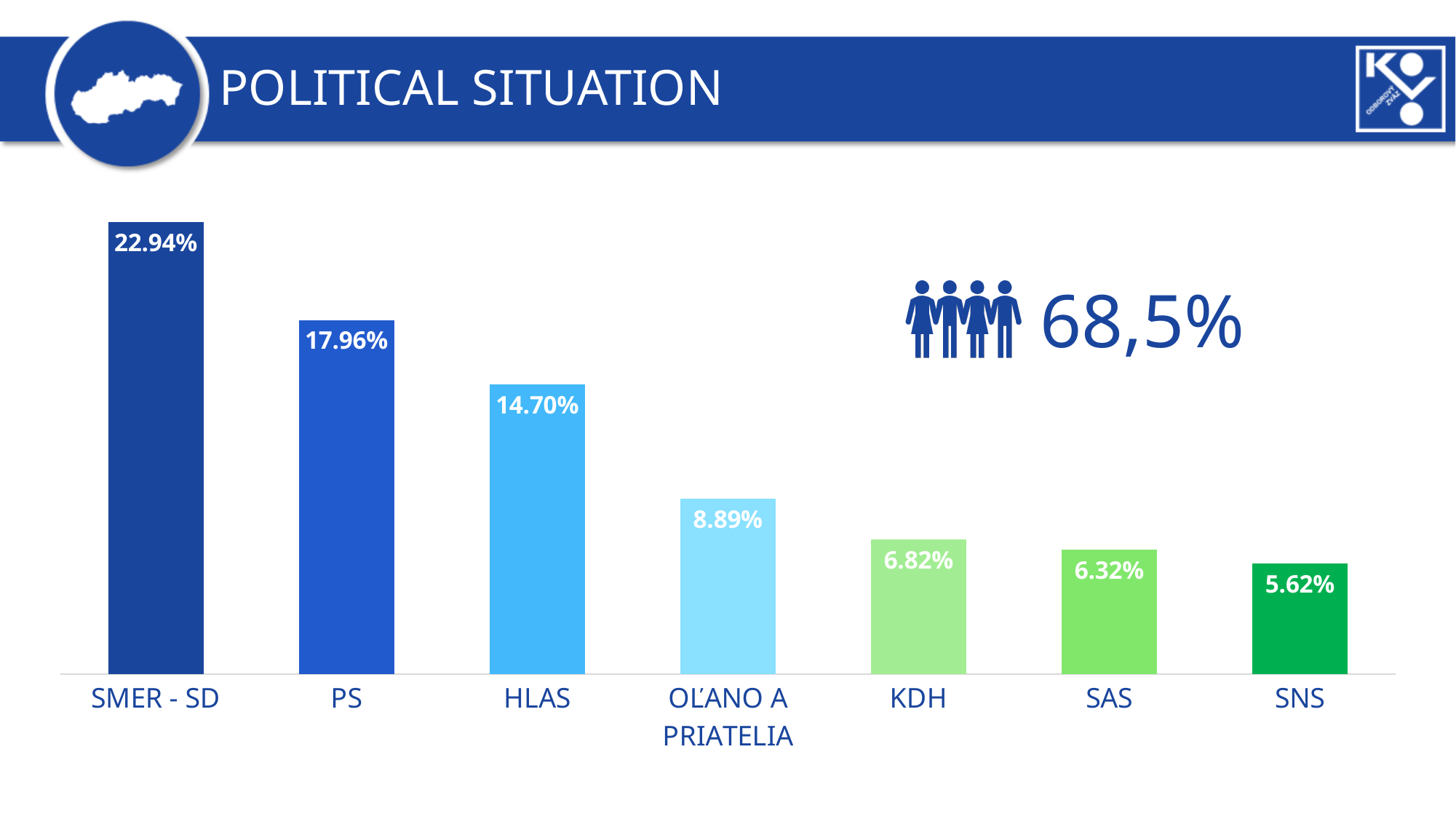
What is the value for SNS? 5.62% Which is larger, the value for PS or the value for HLAS? PS Do the values rise or fall from left to right along the x axis? Fall Which party has the lowest value? SNS How many parties are shown in the chart? 7 What is the value for OĽANO A PRIATELIA? 8.89% What kind of chart is shown on the slide? Bar chart Which party has the highest value? SMER - SD What is the value for HLAS? 14.70% What is the difference between the values for KDH and SAS? 0.50% What is the difference between the values for SMER - SD and PS? 4.98% What is the value for SMER - SD? 22.94%